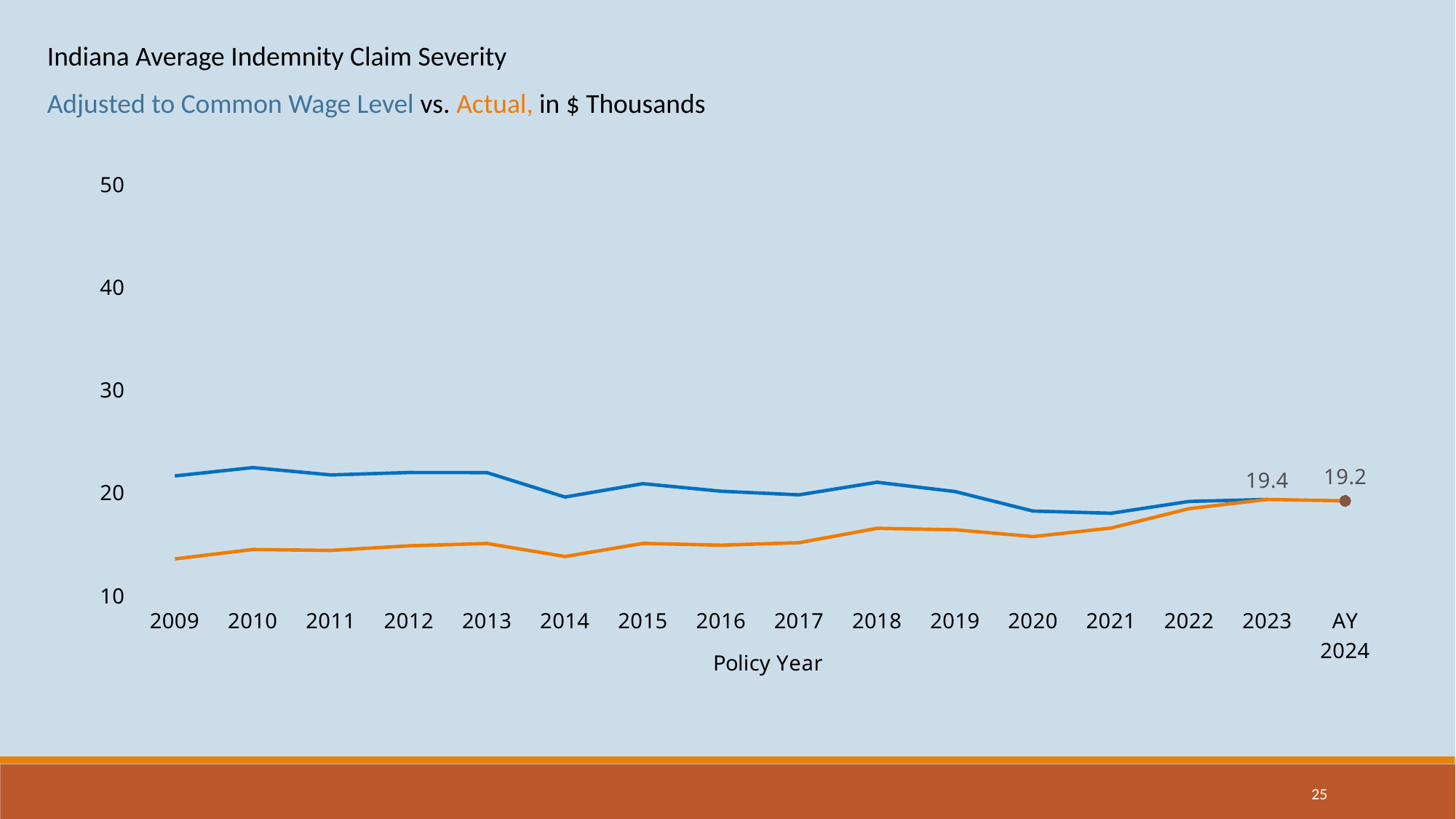
In 2009, which series has the higher value, Adjusted to Common Wage Level or Actual? Adjusted to Common Wage Level Is the Adjusted to Common Wage Level value for 2009 greater or less than 20? greater Is the Actual value for 2009 greater or less than 20? less What kind of chart is shown on the slide? line chart How many series are plotted on the chart? 2 What is the difference between the labelled values for 2023 and AY 2024? 0.2 What value is labelled at AY 2024? 19.2 Which labelled value is larger, 2023 or AY 2024? 2023 How many policy years are shown on the x axis? 16 What value is labelled at 2023? 19.4 Does the Actual series generally rise or fall from 2009 to AY 2024? rise What colour is the Actual series line? orange